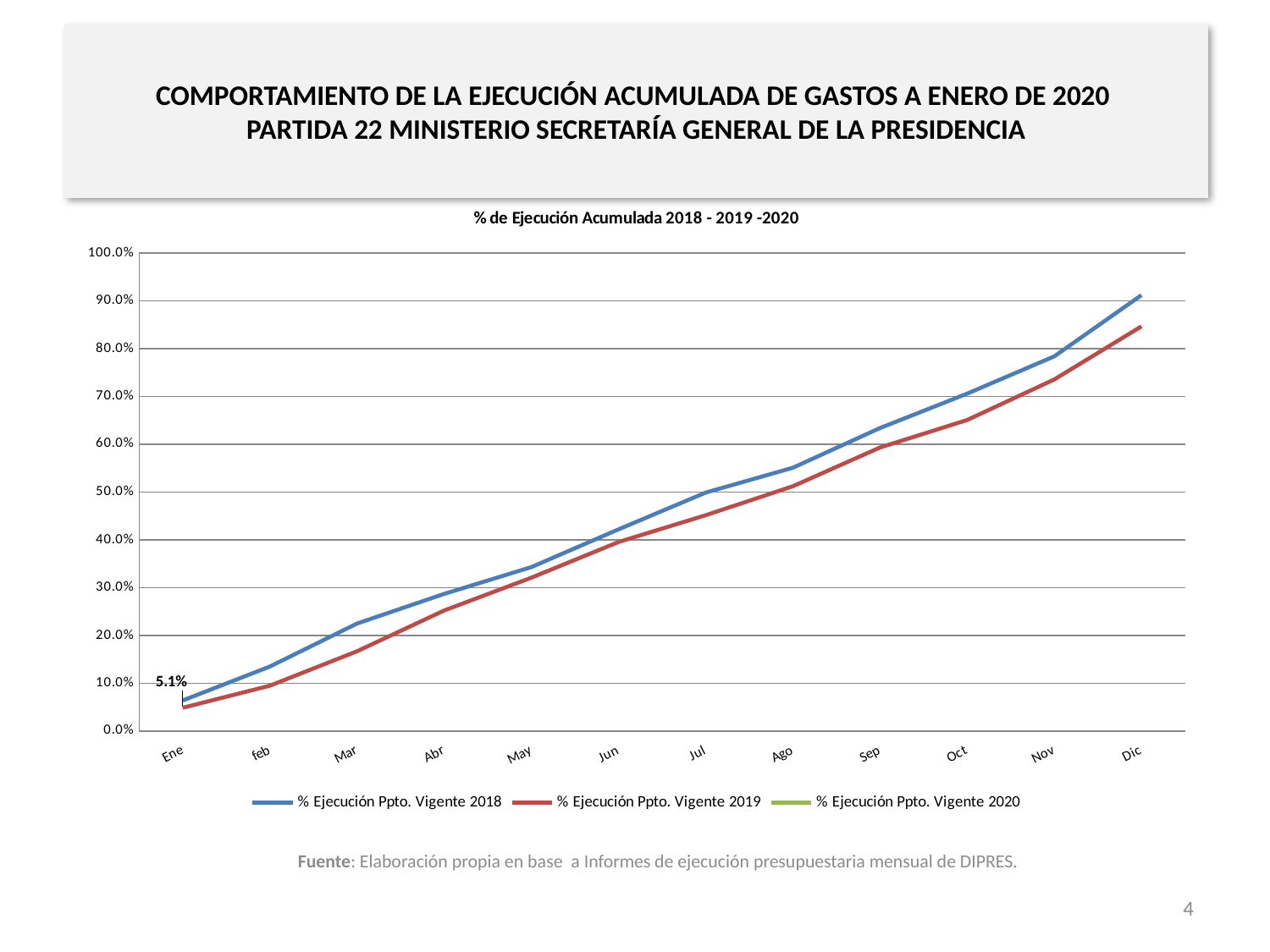
In which month is the value for % Ejecución Ppto. Vigente 2018 lowest? Ene Is the value for % Ejecución Ppto. Vigente 2018 at Ago greater or less than 50.0%? greater Is the value for % Ejecución Ppto. Vigente 2019 at Mar greater or less than 20.0%? less Do the values for % Ejecución Ppto. Vigente 2018 rise or fall from Ene to Dic? rise What is the title of the chart? % de Ejecución Acumulada 2018 - 2019 -2020 At Dic, which series is higher: % Ejecución Ppto. Vigente 2018 or % Ejecución Ppto. Vigente 2019? % Ejecución Ppto. Vigente 2018 Is the value for % Ejecución Ppto. Vigente 2019 at Dic greater or less than 80.0%? greater What kind of chart is shown on the slide? line chart How many months are shown along the x axis? 12 In which month is the value for % Ejecución Ppto. Vigente 2019 highest? Dic What value is printed as a data label at Ene on the chart? 5.1% How many series does the legend list? 3